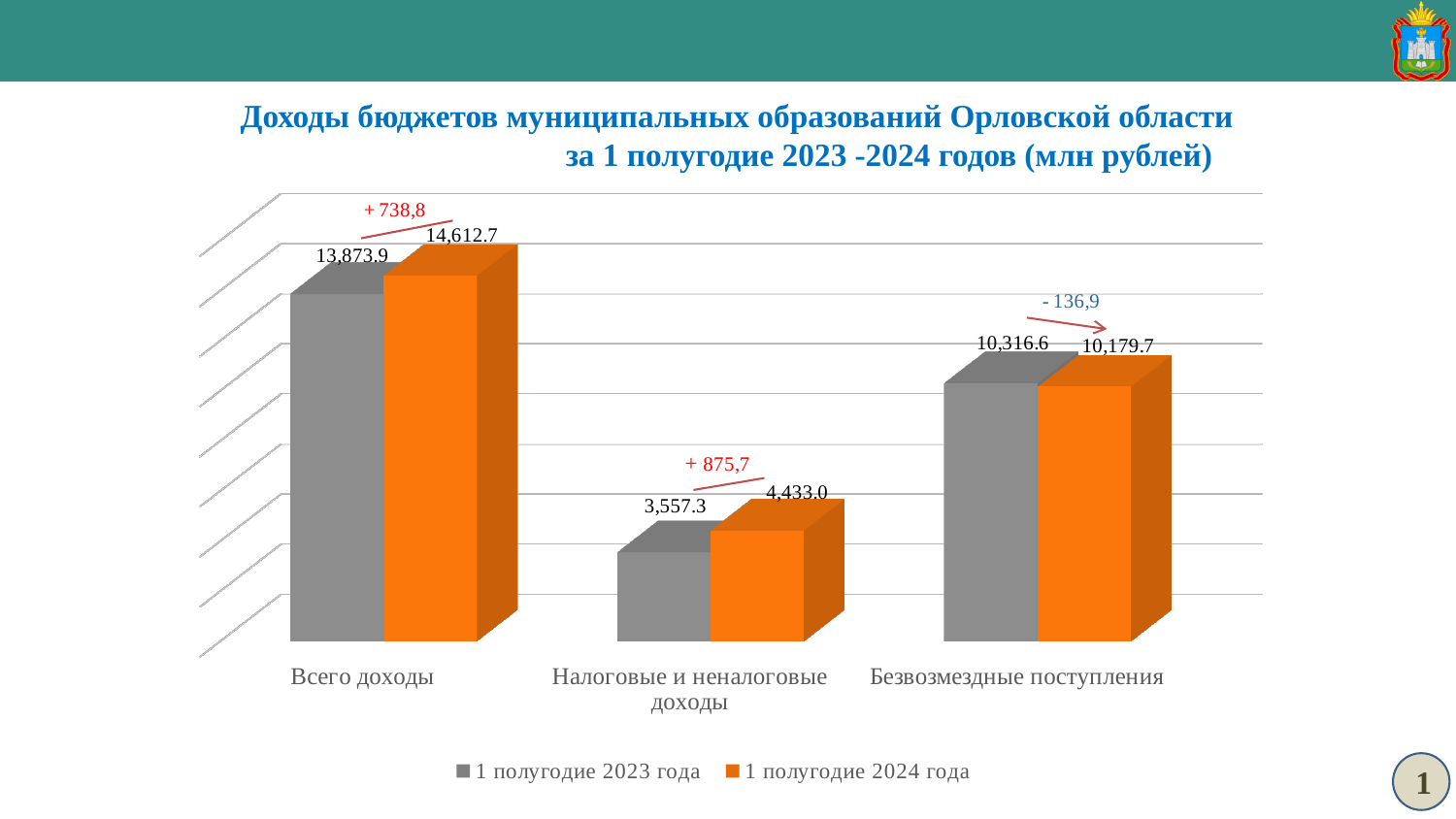
Which category has the highest value in the 1 полугодие 2024 года series? Всего доходы How many categories are shown on the x axis? 3 What is the value for Всего доходы in the 1 полугодие 2024 года series? 14,612.7 What is the value for Всего доходы in the 1 полугодие 2023 года series? 13,873.9 For Безвозмездные поступления, which series has the larger value: 1 полугодие 2023 года or 1 полугодие 2024 года? 1 полугодие 2023 года What is the difference between the 1 полугодие 2024 года and 1 полугодие 2023 года values for Налоговые и неналоговые доходы? 875.7 What is the value for Налоговые и неналоговые доходы in the 1 полугодие 2024 года series? 4,433.0 How many series does the legend list? 2 What kind of chart is shown on the slide? Bar chart What change is annotated above the Безвозмездные поступления bars? - 136,9 What is the value for Безвозмездные поступления in the 1 полугодие 2023 года series? 10,316.6 Which category has the lowest value in the 1 полугодие 2023 года series? Налоговые и неналоговые доходы